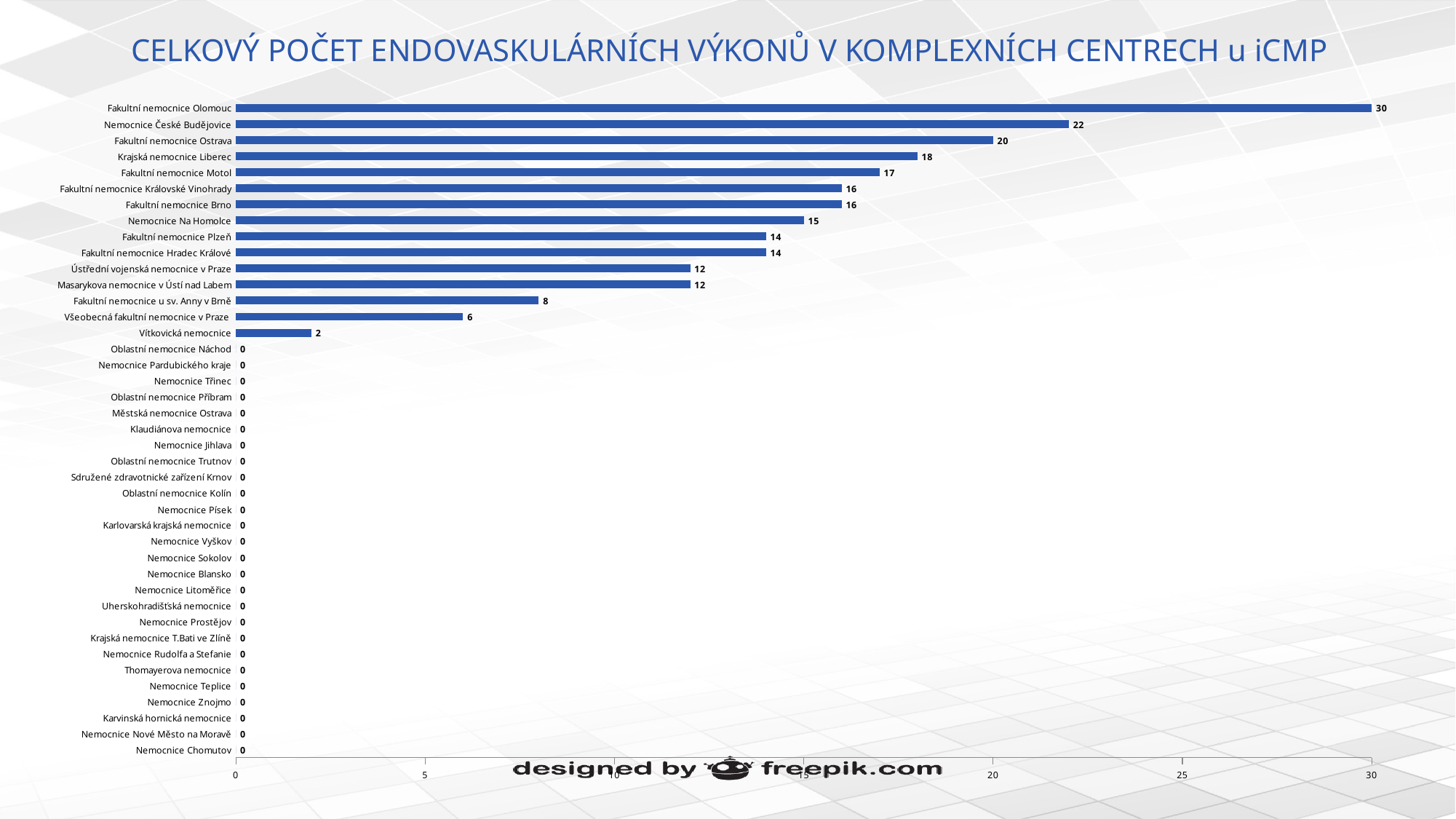
What is the value for Nemocnice Na Homolce? 15 What is the value for Vítkovická nemocnice? 2 What is the title of the chart? CELKOVÝ POČET ENDOVASKULÁRNÍCH VÝKONŮ V KOMPLEXNÍCH CENTRECH u iCMP What kind of chart is shown on the slide? bar chart Which is larger, the value for Krajská nemocnice Liberec or the value for Fakultní nemocnice Brno? Krajská nemocnice Liberec Which hospital has the highest value? Fakultní nemocnice Olomouc Is the value for Fakultní nemocnice u sv. Anny v Brně greater or less than 10? less How many hospitals are listed on the chart? 41 What is the value for Všeobecná fakultní nemocnice v Praze? 6 What is the difference between the values for Nemocnice České Budějovice and Fakultní nemocnice Ostrava? 2 What is the difference between the values for Fakultní nemocnice Olomouc and Fakultní nemocnice Motol? 13 What is the value for Fakultní nemocnice Olomouc? 30